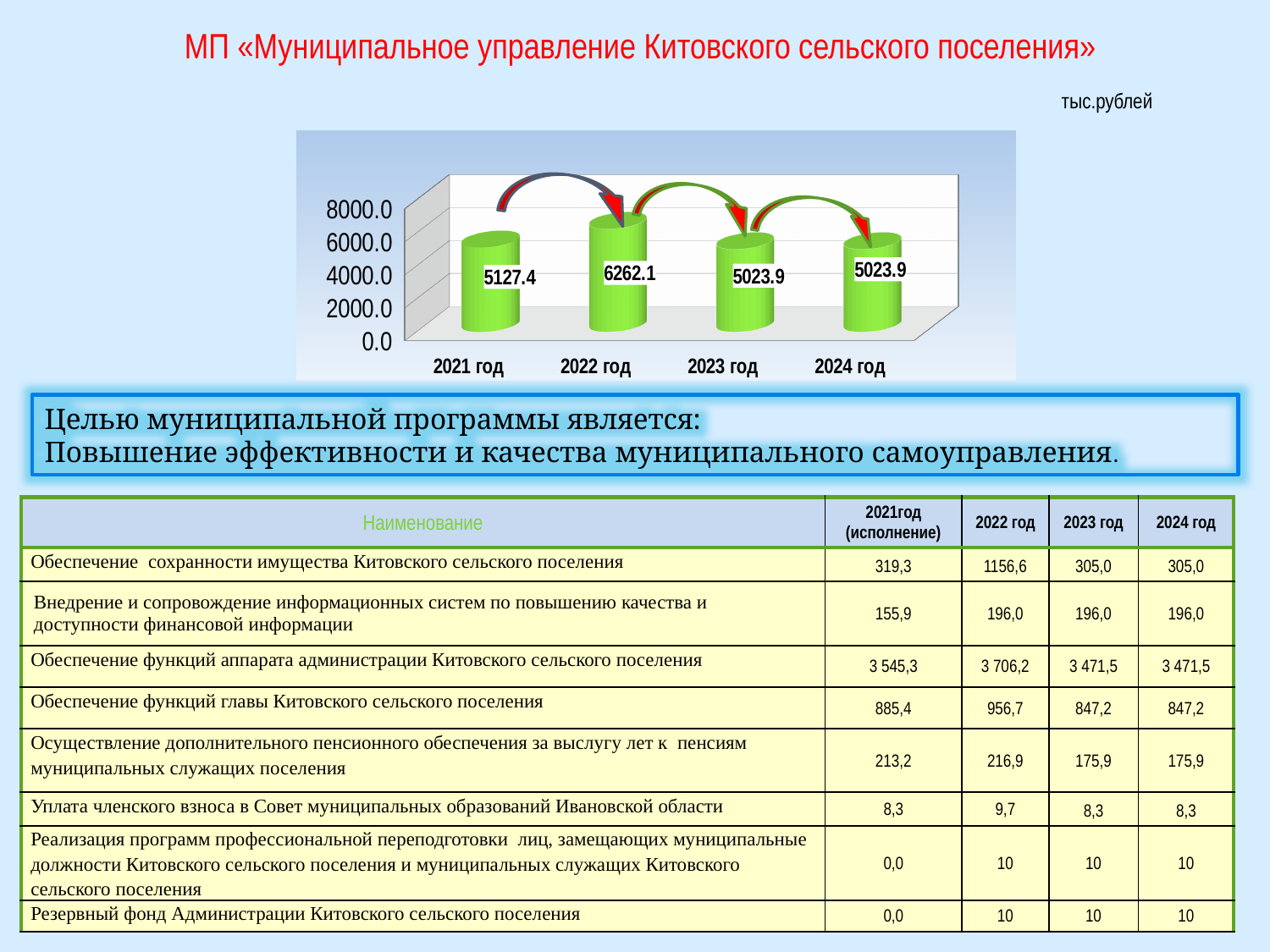
What is the value shown for 2022 год? 6262.1 In what units are the chart values given, according to the label above the chart? тыс.рублей Is the value for 2023 год greater or less than 6000.0? less What is the difference between the values for 2022 год and 2023 год? 1238.2 Which is larger, the value for 2021 год or the value for 2023 год? 2021 год What is the value shown for 2021 год? 5127.4 What is the difference between the values for 2022 год and 2021 год? 1134.7 Which year has the highest value in the chart? 2022 год How many years are shown on the x axis of the chart? 4 What is the value shown for 2024 год? 5023.9 Is the value for 2022 год greater or less than 6000.0? greater What kind of chart is shown on the slide? bar chart